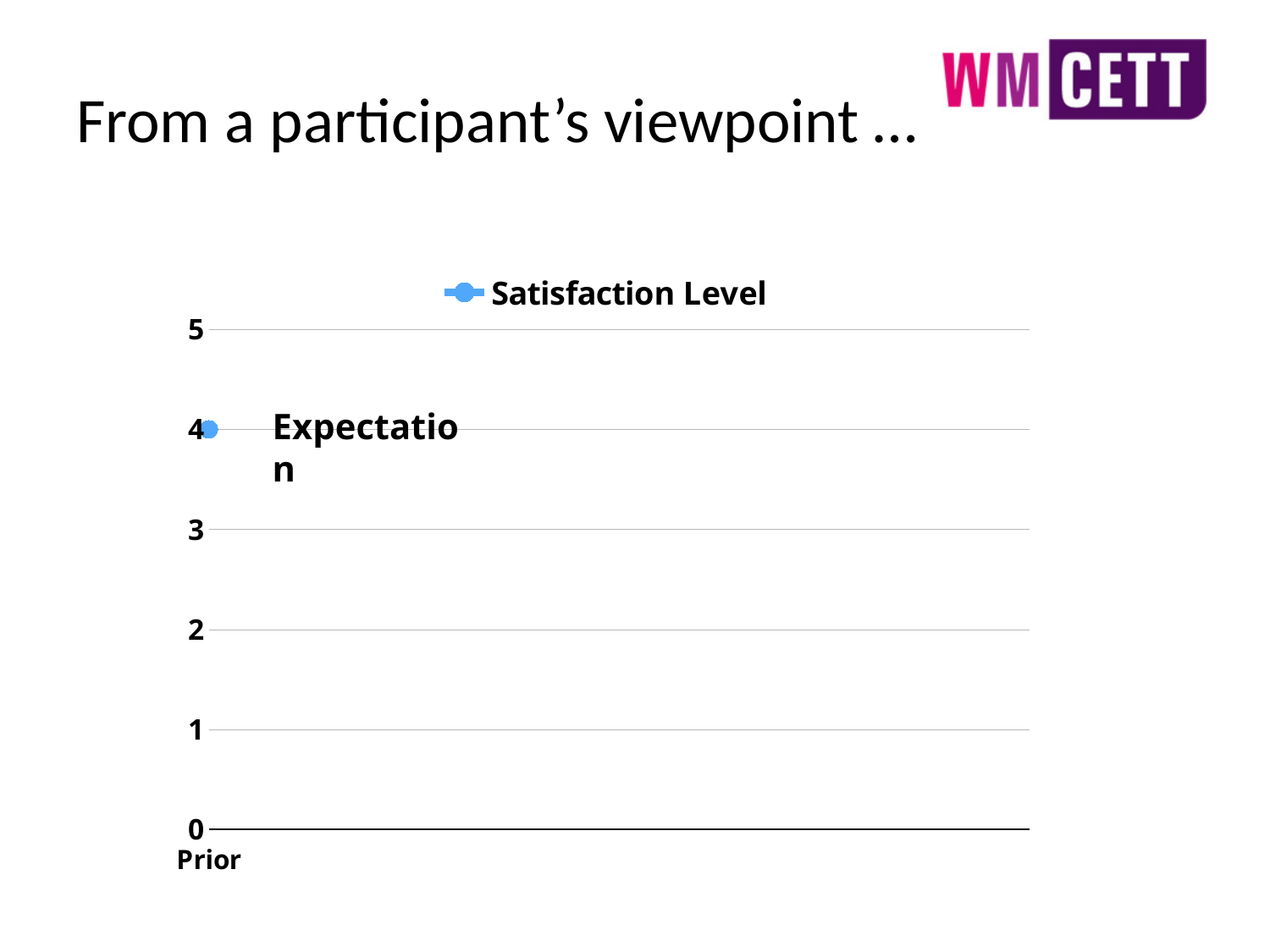
How many data points are plotted on the chart? 1 What is the Satisfaction Level value at Prior? 4 What is the name of the series shown in the chart legend? Satisfaction Level How many series does the chart legend list? 1 What kind of chart is shown on the slide? line chart What category label appears on the x axis of the chart? Prior What is the highest value shown on the chart's y axis? 5 Is the Satisfaction Level value at Prior greater or less than 5? less Is the Satisfaction Level value at Prior greater or less than 3? greater